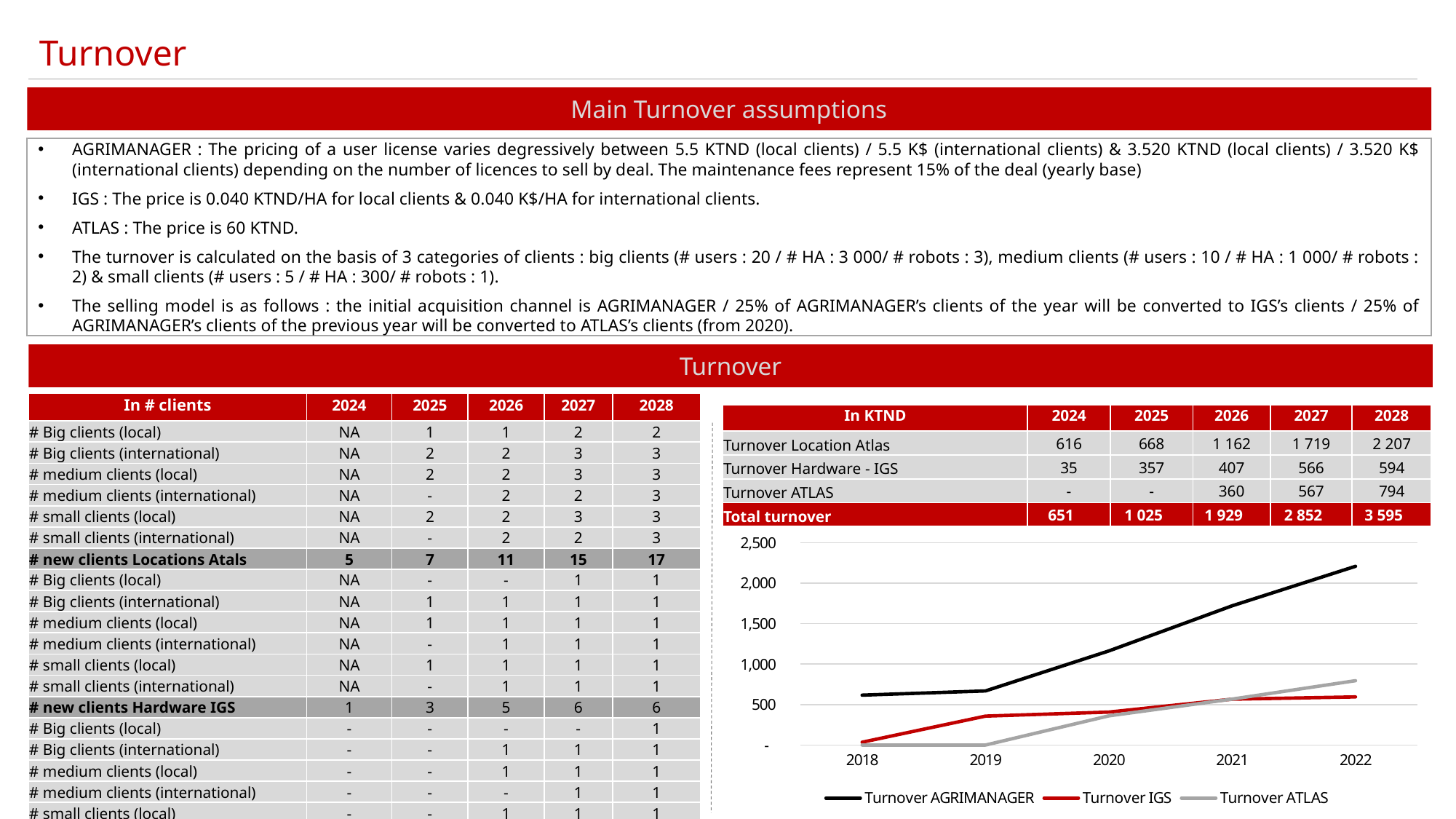
Is the value for Turnover AGRIMANAGER in 2022 greater or less than 2,000? greater Is the value for Turnover AGRIMANAGER in 2018 greater or less than 1,000? less Does the Turnover AGRIMANAGER line rise or fall from 2018 to 2022? rise How many years are shown along the x axis of the chart? 5 Is the value for Turnover AGRIMANAGER in 2021 greater or less than 1,500? greater How many series does the chart's legend list? 3 In 2022, which is higher: Turnover ATLAS or Turnover IGS? Turnover ATLAS What kind of chart is shown on the slide? line chart Which series has the highest value in 2022? Turnover AGRIMANAGER What colour is the Turnover AGRIMANAGER line in the chart? black